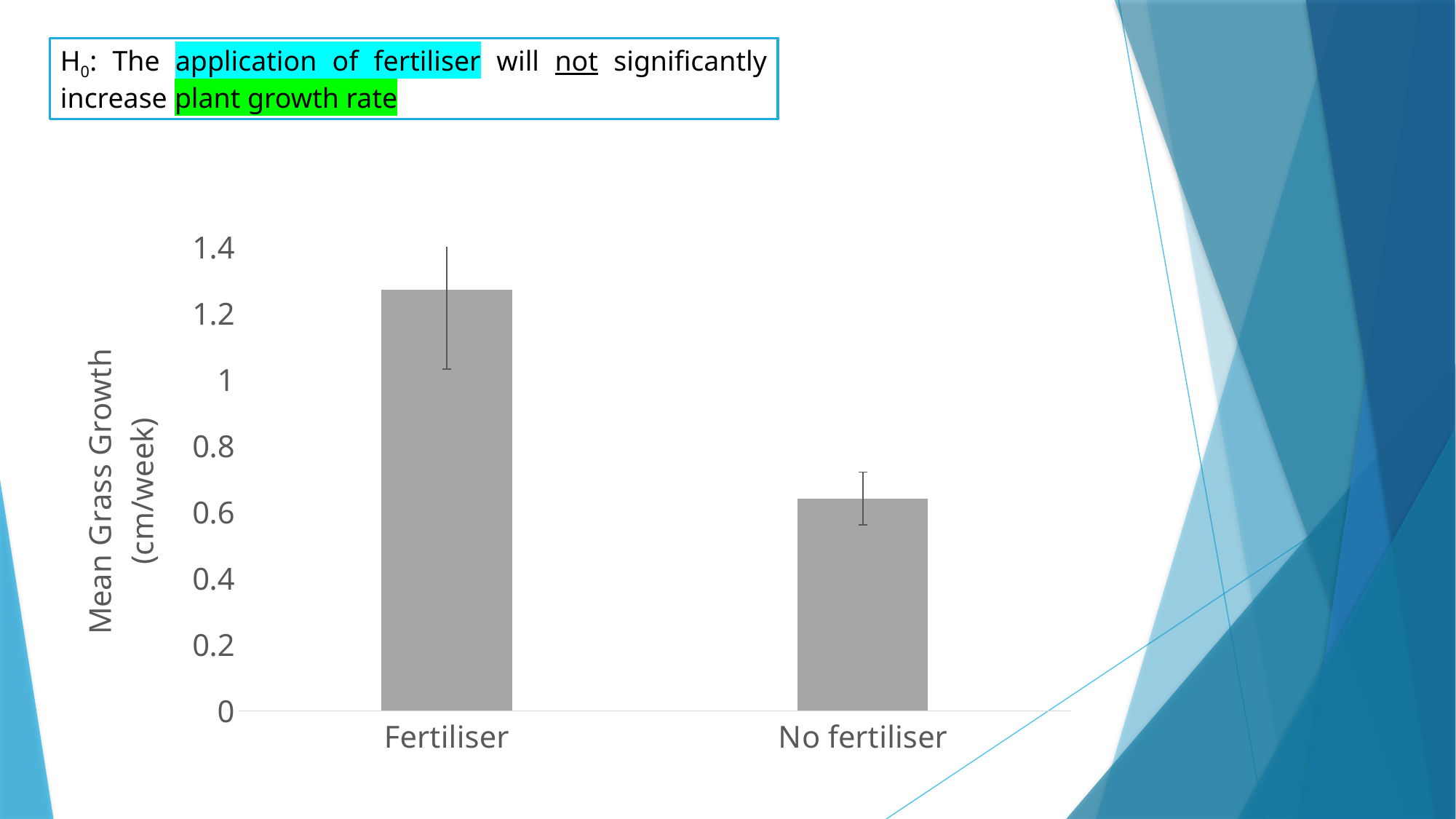
Is the value for No fertiliser greater or less than 0.8? less Is the value for Fertiliser greater or less than 1.4? less How many categories are plotted on the x axis? 2 Do the bar values rise or fall from left to right along the x axis? fall Which category has the highest mean grass growth? Fertiliser Is the value for Fertiliser greater or less than 1? greater Which is larger, the value for Fertiliser or the value for No fertiliser? Fertiliser What kind of chart is shown on the slide? bar chart What is the highest tick value shown on the y axis? 1.4 What is the label of the y axis? Mean Grass Growth (cm/week) Which category has the lowest mean grass growth? No fertiliser